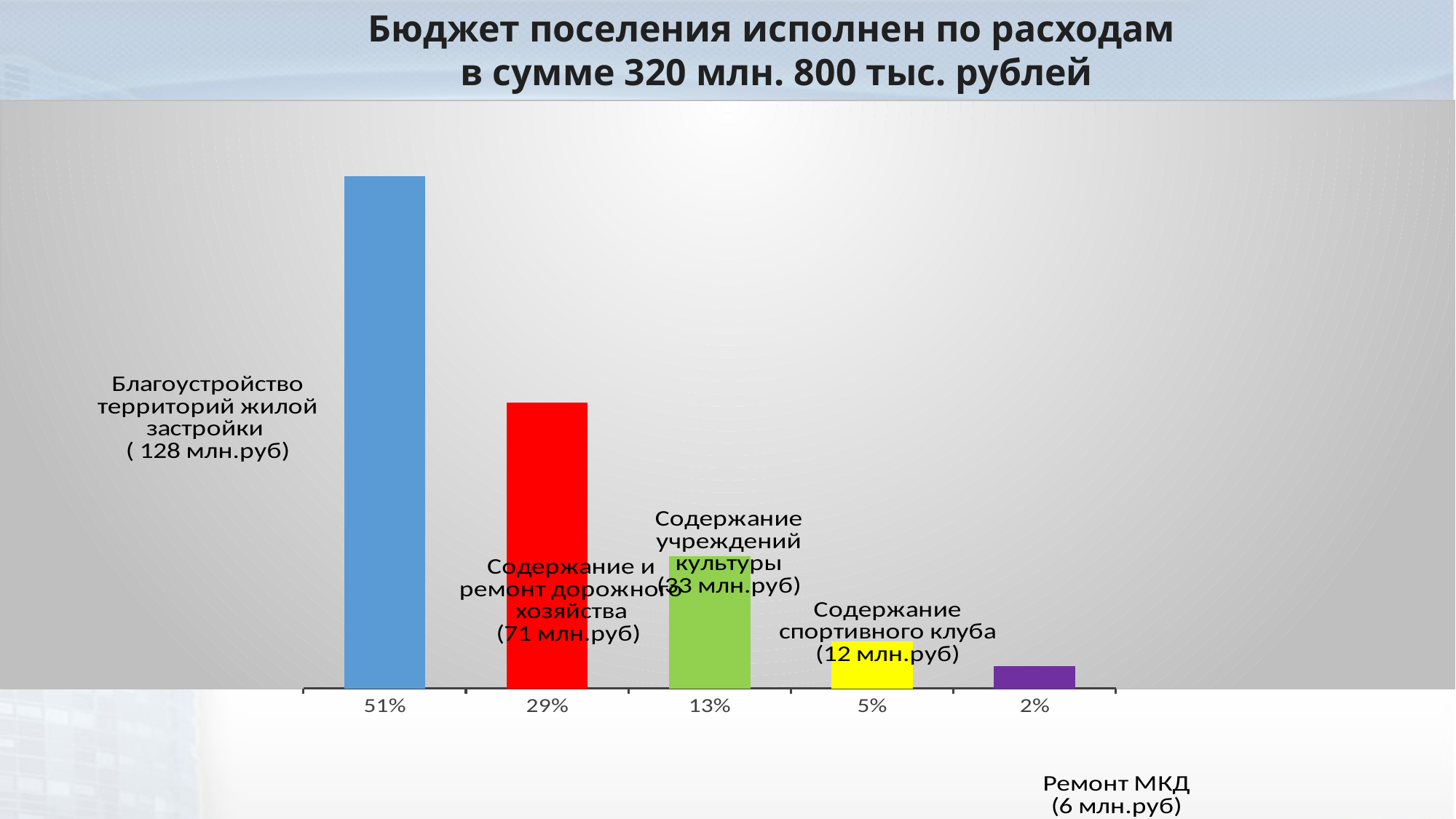
Which is larger: the amount for Содержание спортивного клуба or the amount for Ремонт МКД? Содержание спортивного клуба What is the difference in percentage points between the first bar (51%) and the second bar (29%)? 22 What percentage is shown under the bar for Содержание и ремонт дорожного хозяйства? 29% How many bars are plotted in the chart? 5 Which expenditure category has the lowest bar? Ремонт МКД What percentage is shown under the bar for Благоустройство территорий жилой застройки? 51% Which expenditure category has the highest bar? Благоустройство территорий жилой застройки According to the slide title, what is the total amount of budget expenditures executed? 320 млн. 800 тыс. рублей What amount in млн.руб is given for Ремонт МКД? 6 млн.руб What amount in млн.руб is given for Содержание учреждений культуры? 33 млн.руб What kind of chart is shown on the slide? Bar chart Do the bar values rise or fall from left to right along the x axis? Fall